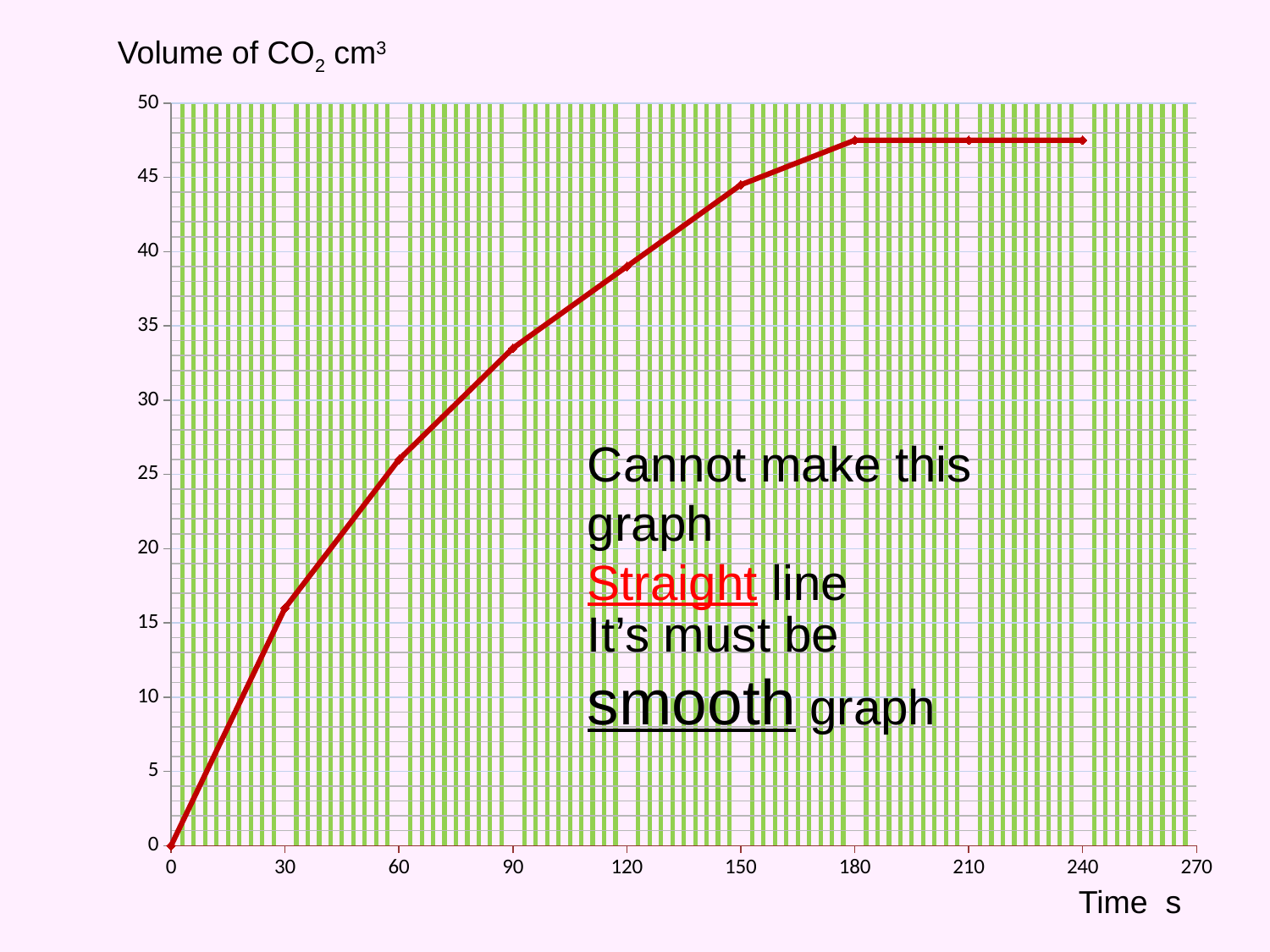
What is the label on the x axis of the chart? Time s How does the volume of CO2 change as time increases from 0 to 240 s? It rises, then levels off Is the volume of CO2 at 180 s greater or less than 50? less Is the volume of CO2 at 30 s greater or less than 10? greater What kind of chart is shown on the slide? line chart Is the volume of CO2 at 90 s greater or less than 30? greater What is the volume of CO2 at time 0 s? 0 At which time is the volume of CO2 lowest? 0 Which is larger, the volume of CO2 at 30 s or at 150 s? 150 s How many data points are plotted on the line? 9